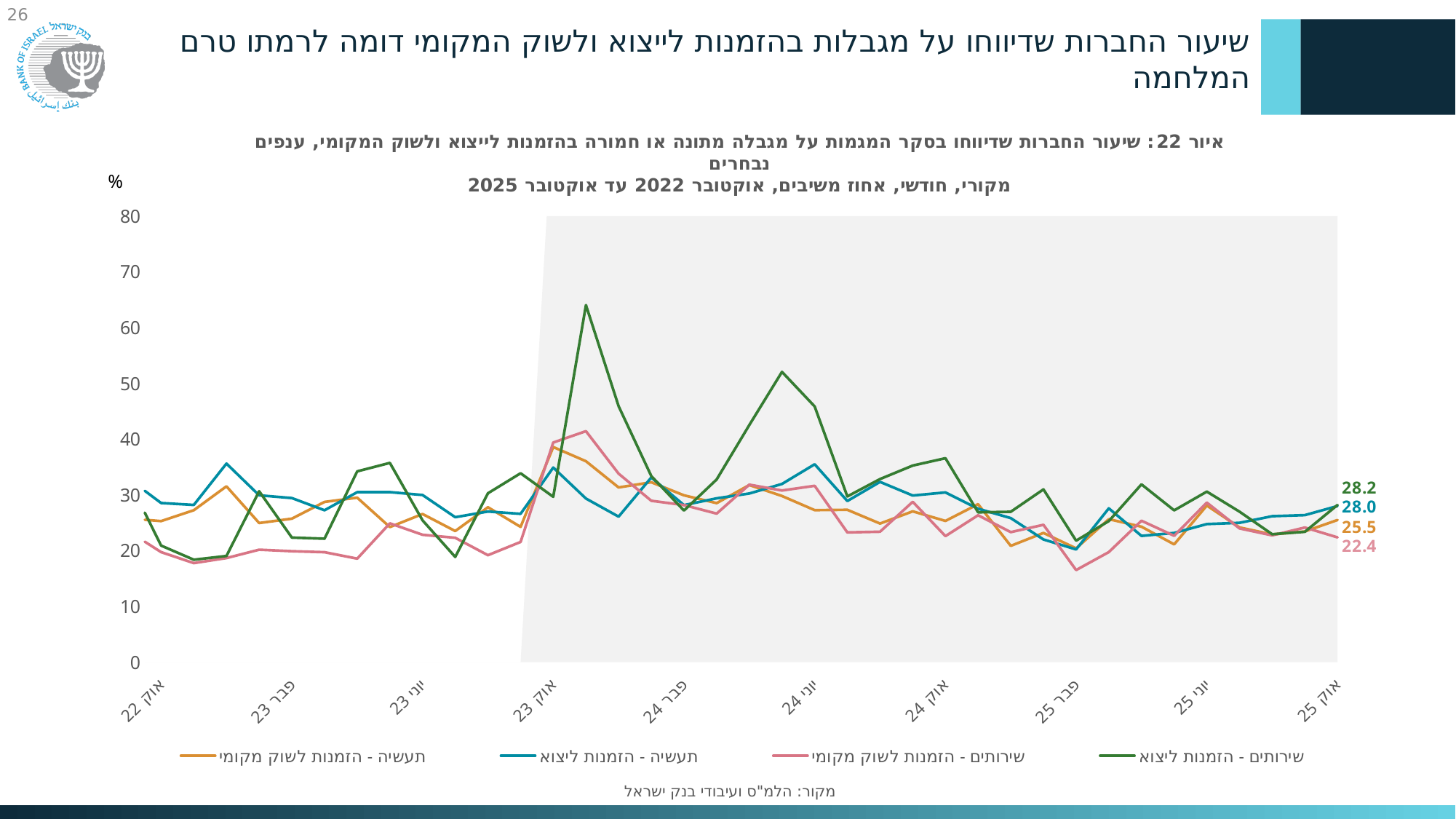
What is the unit shown on the y axis of the chart? % Is the peak value of the series שירותים - הזמנות ליצוא shortly after אוק 23 greater or less than 60? greater What is the final value (אוק 25) labelled for the series תעשיה - הזמנות ליצוא? 28.0 Which series has the lowest labelled value at the end of the chart (אוק 25)? שירותים - הזמנות לשוק מקומי What is the final value (אוק 25) labelled for the series שירותים - הזמנות לשוק מקומי? 22.4 How many series does the legend list? 4 Which series has the highest labelled value at the end of the chart (אוק 25)? שירותים - הזמנות ליצוא At the end of the chart, which is larger: the value for תעשיה - הזמנות לשוק מקומי or the value for שירותים - הזמנות לשוק מקומי? תעשיה - הזמנות לשוק מקומי What type of chart is shown on the slide? line chart What is the final value (אוק 25) labelled for the series תעשיה - הזמנות לשוק מקומי? 25.5 What is the difference between the final labelled values of שירותים - הזמנות ליצוא (28.2) and שירותים - הזמנות לשוק מקומי (22.4)? 5.8 What is the final value (אוק 25) labelled for the series שירותים - הזמנות ליצוא? 28.2